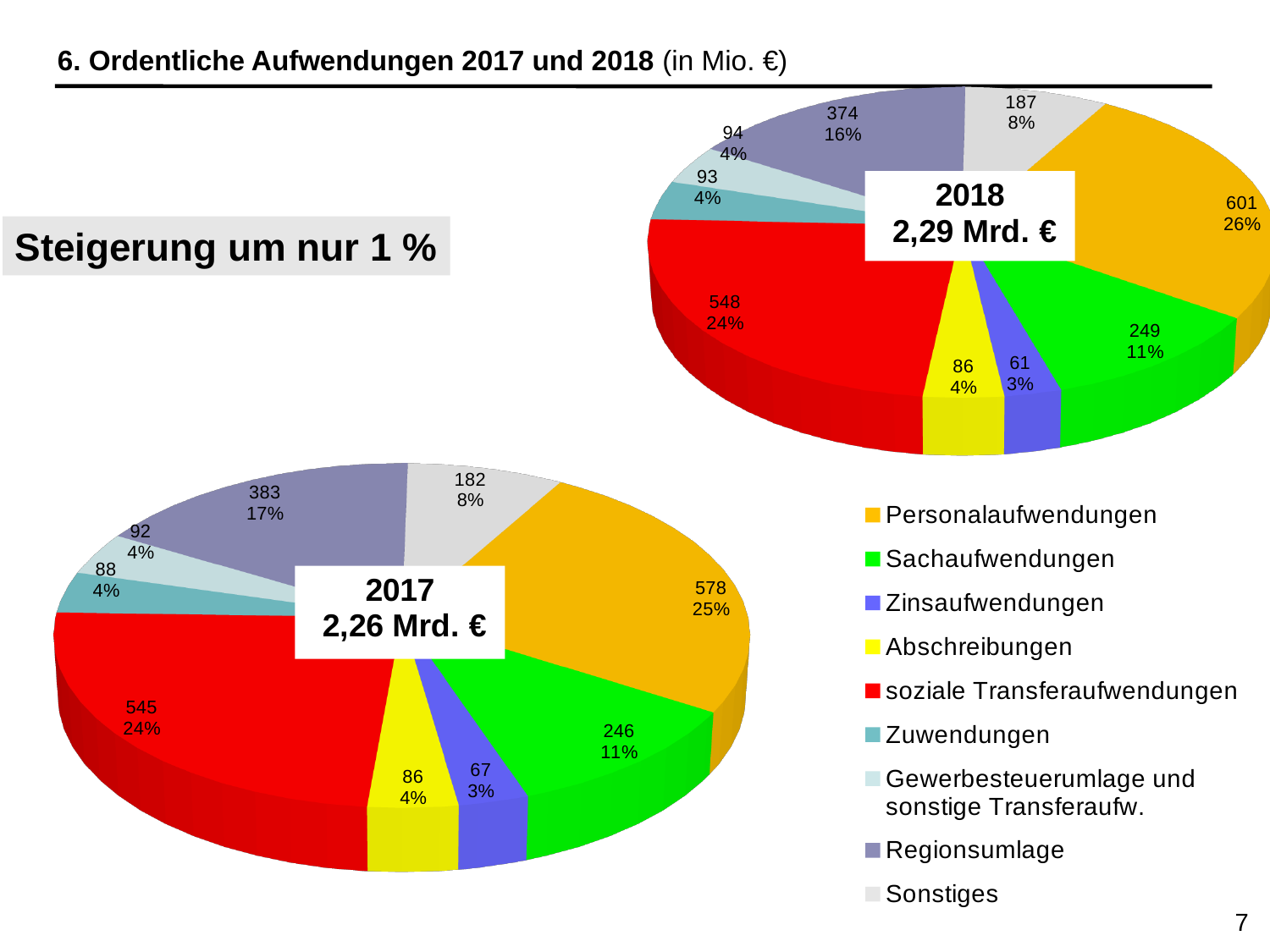
In the 2017 pie chart, what share of the pie is Sonstiges? 8% How many categories does the legend list? 9 In the 2017 pie chart, which category has the smallest value? Zinsaufwendungen Which is larger: Sachaufwendungen in 2018 or Sachaufwendungen in 2017? Sachaufwendungen in 2018 In the 2018 pie chart, which category has the largest value? Personalaufwendungen What type of chart is used on this slide? Pie chart In the 2017 pie chart, what is the value for Regionsumlage? 383 What total is shown in the centre of the 2017 pie chart? 2,26 Mrd. € In the 2018 pie chart, what share of the pie is soziale Transferaufwendungen? 24% In the 2018 pie chart, what is the value for Personalaufwendungen? 601 In the 2018 pie chart, what is the difference between Personalaufwendungen and soziale Transferaufwendungen? 53 Which colour represents Abschreibungen in the legend? Yellow